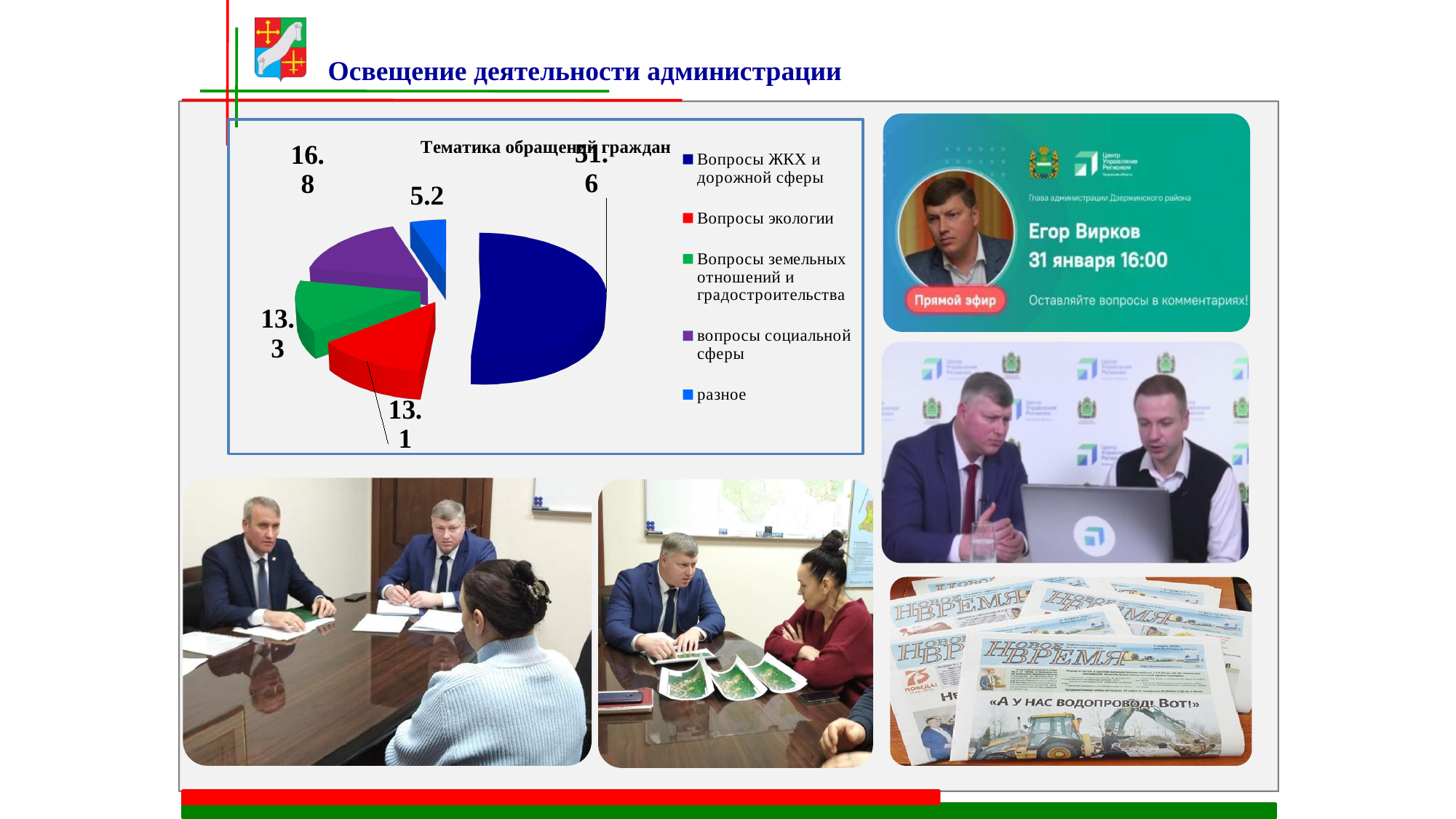
What is the value for Вопросы земельных отношений и градостроительства? 13.3 What is the value for Вопросы экологии? 13.1 What is the difference between the values for Вопросы ЖКХ и дорожной сферы and вопросы социальной сферы? 34.8 What is the value for Вопросы ЖКХ и дорожной сферы? 51.6 What is the title of the pie chart? Тематика обращений граждан How many categories does the legend of the pie chart list? 5 Which category has the largest slice of the pie? Вопросы ЖКХ и дорожной сферы Which category has the smallest slice of the pie? разное What is the value for разное? 5.2 What type of chart is shown on the slide? pie chart Which is larger: the value for вопросы социальной сферы or the value for разное? вопросы социальной сферы What is the value for вопросы социальной сферы? 16.8